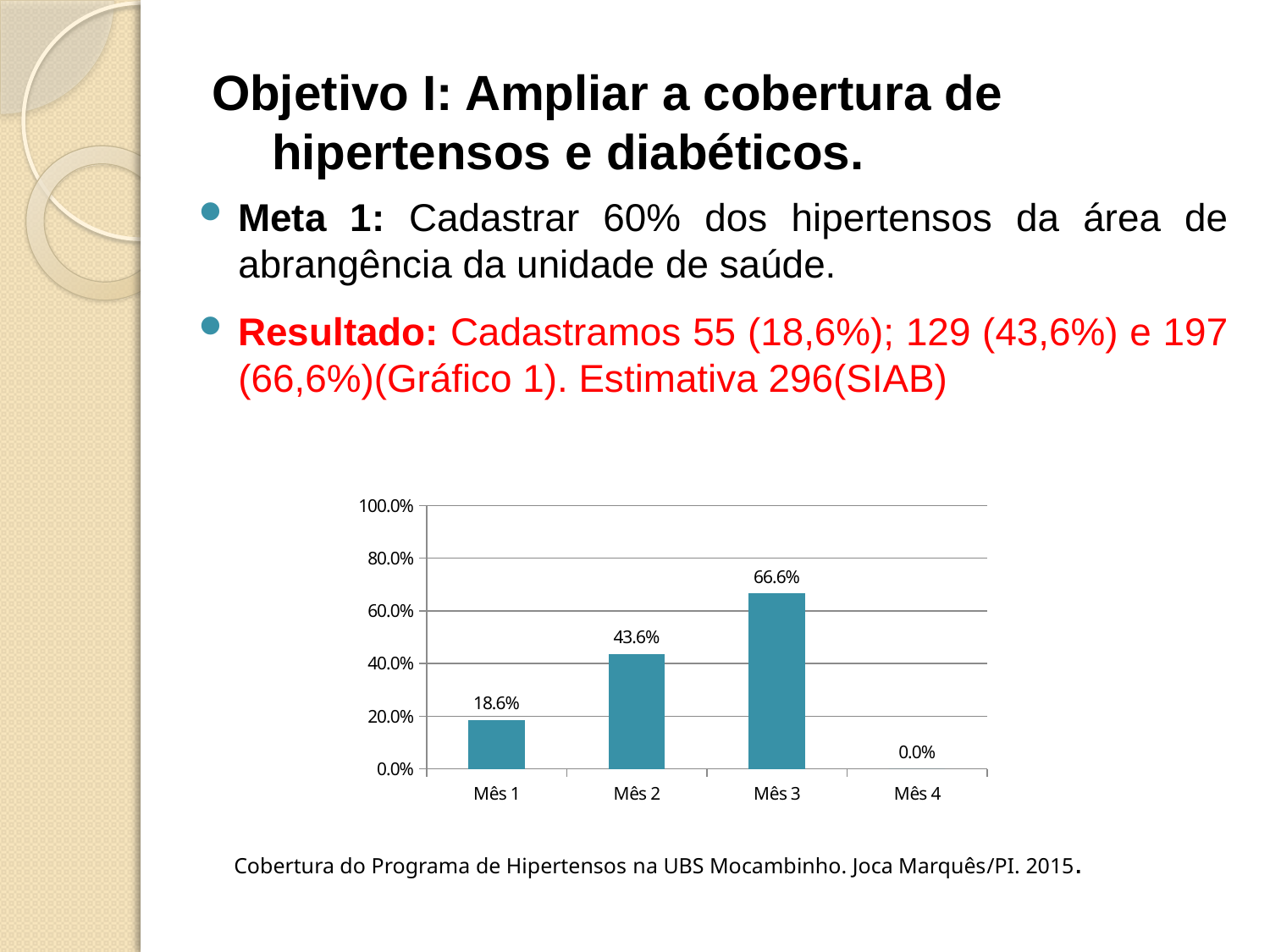
What is the difference between the values for Mês 2 and Mês 1? 25.0% Is the value for Mês 3 greater or less than 60.0%? greater Which is larger, the value for Mês 1 or the value for Mês 2? Mês 2 Which month has the highest value? Mês 3 Which month has the lowest value? Mês 4 What is the value for Mês 2? 43.6% What is the value for Mês 3? 66.6% What is the difference between the values for Mês 3 and Mês 2? 23.0% What is the value for Mês 1? 18.6% What is the value for Mês 4? 0.0% How many categories are shown on the x axis? 4 What kind of chart is shown on the slide? bar chart